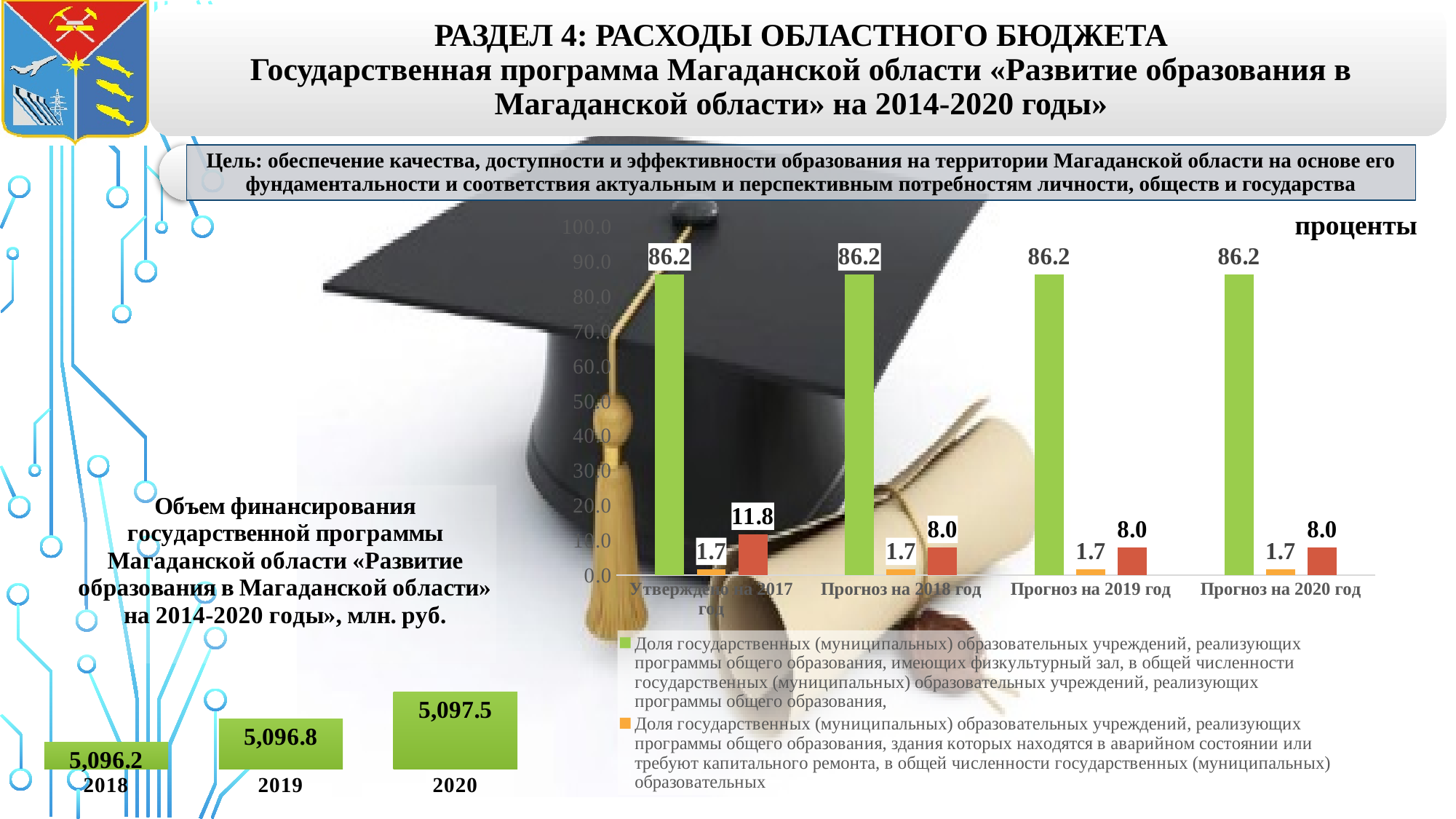
On the left chart (Объем финансирования), what is the difference between the 2020 and 2018 values? 1.3 On the left chart (Объем финансирования), what is the value for 2020? 5,097.5 On the left chart (Объем финансирования), how many years are shown? 3 What kind of chart is the right chart (проценты)? bar chart On the right chart (проценты), what is the value of the green bar for Прогноз на 2019 год? 86.2 On the left chart (Объем финансирования), what is the value for 2018? 5,096.2 On the left chart (Объем финансирования), which year has the highest value? 2020 On the right chart (проценты), what is the value of the red bar for Утверждено на 2017 год? 11.8 On the right chart (проценты), how many categories are shown on the x axis? 4 On the right chart (проценты), what is the value of the orange bar for Прогноз на 2020 год? 1.7 On the right chart (проценты), what is the difference between the red bar values for Утверждено на 2017 год and Прогноз на 2018 год? 3.8 On the left chart (Объем финансирования), do the values rise or fall from 2018 to 2020? rise